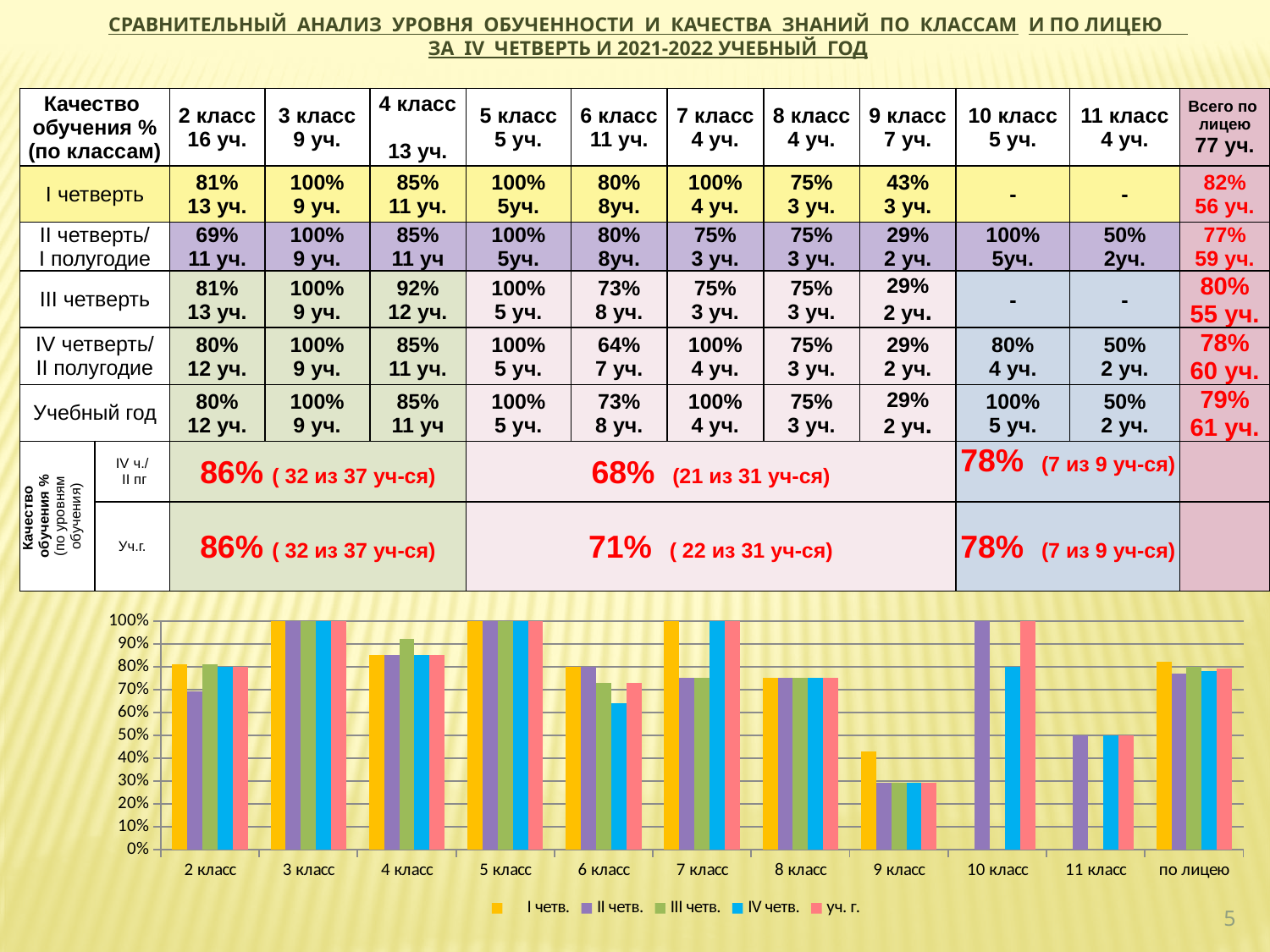
In the bar chart, is the уч. г. value for 6 класс greater or less than 80%? less How many categories are shown along the x axis of the bar chart? 11 In the bar chart, which is larger: the IV четв. bar for 6 класс or the IV четв. bar for 7 класс? 7 класс What kind of chart is shown at the bottom of the slide? bar chart In the bar chart, what is the value of the IV четв. bar for 11 класс? 50% In the bar chart, what is the value of the IV четв. bar for 10 класс? 80% What are the legend entries of the bar chart? I четв., II четв., III четв., IV четв., уч. г. In the bar chart, what is the value of the I четв. bar for 3 класс? 100% In the bar chart, which class has the lowest I четв. bar? 9 класс How many series does the legend of the bar chart list? 5 In the bar chart, is the III четв. value for 4 класс greater or less than 80%? greater In the bar chart, is the II четв. value for 9 класс greater or less than 40%? less